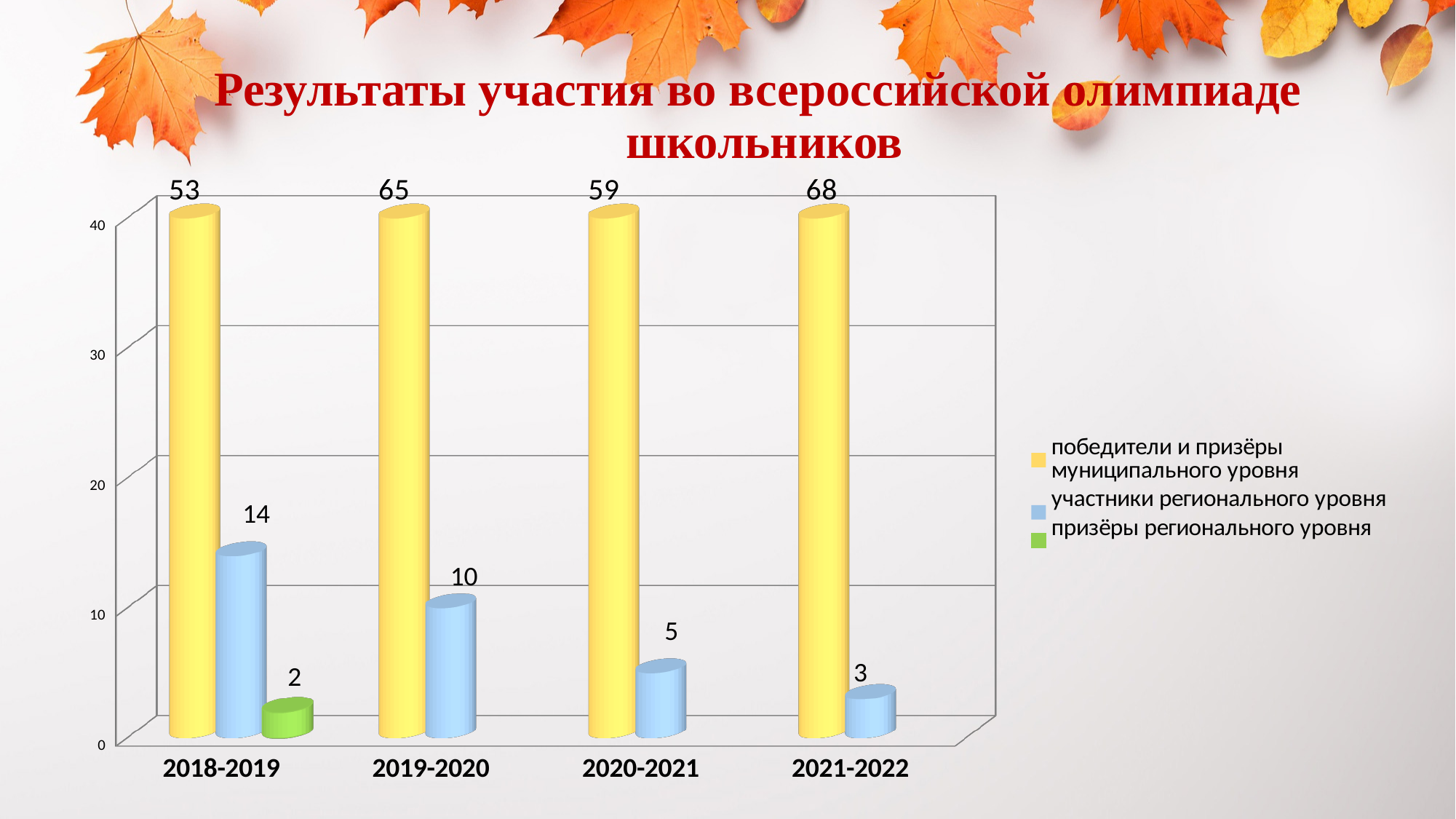
What is the value for призёры регионального уровня in 2018-2019? 2 What kind of chart is shown on the slide? bar chart How many year categories are shown on the x axis? 4 In which year is the value for победители и призёры муниципального уровня the highest? 2021-2022 What is the value for участники регионального уровня in 2018-2019? 14 Does the value for участники регионального уровня in 2018-2019 rise or fall across the years to 2021-2022? fall In which year is the value for участники регионального уровня the lowest? 2021-2022 What is the value for победители и призёры муниципального уровня in 2021-2022? 68 How many series does the legend list? 3 Which colour represents призёры регионального уровня in the legend? green Which is larger: участники регионального уровня in 2019-2020 or in 2020-2021? 2019-2020 What is the difference between the values for победители и призёры муниципального уровня in 2019-2020 and 2018-2019? 12